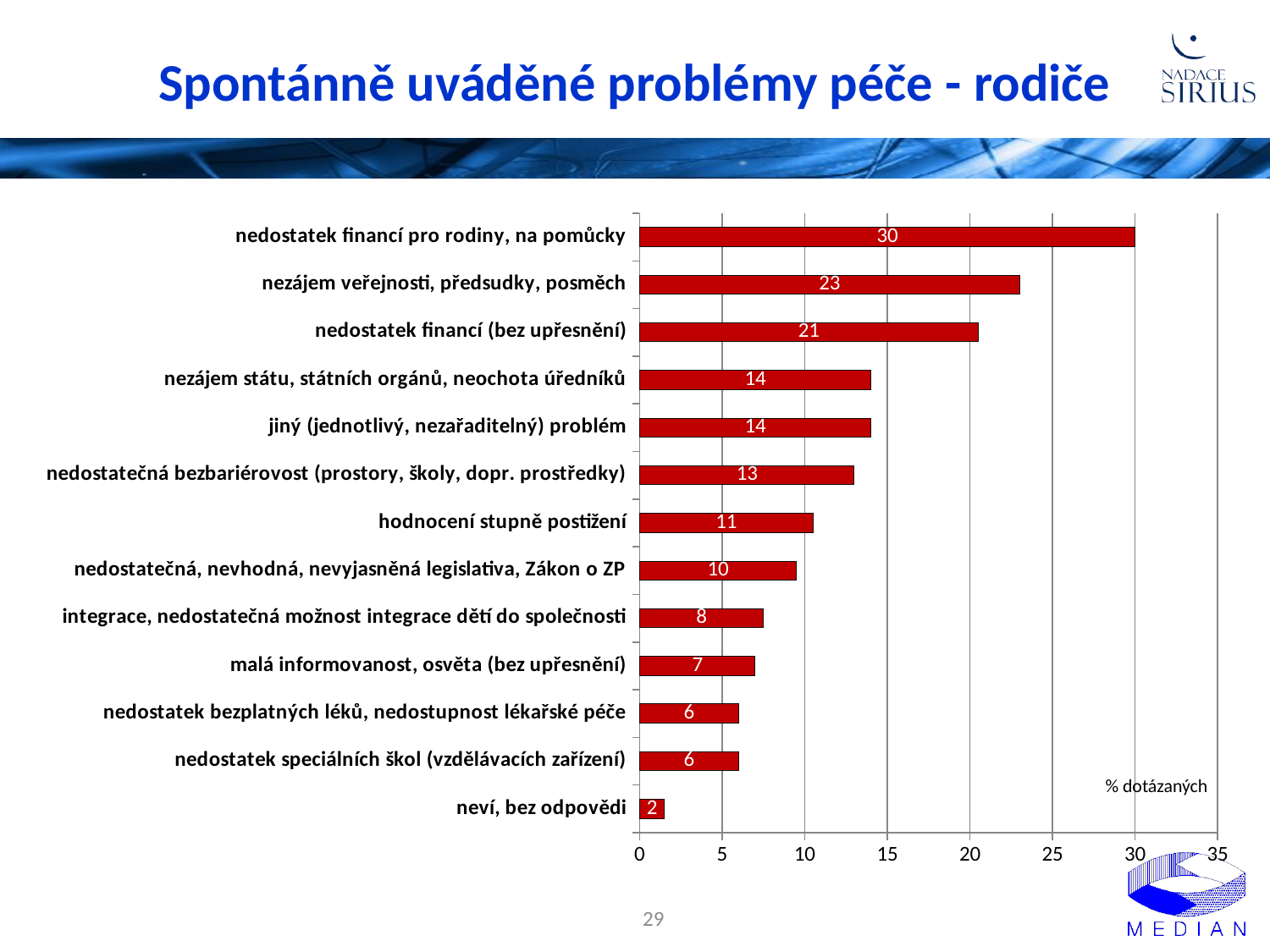
What is the value for "neví, bez odpovědi"? 2 Which is larger: the value for "nedostatečná bezbariérovost (prostory, školy, dopr. prostředky)" or the value for "integrace, nedostatečná možnost integrace dětí do společnosti"? nedostatečná bezbariérovost (prostory, školy, dopr. prostředky) How many categories are shown in the chart? 13 What kind of chart is shown on the slide? bar chart What is the value for "nezájem veřejnosti, předsudky, posměch"? 23 Which category has the highest value? nedostatek financí pro rodiny, na pomůcky What is the value for "nedostatek financí pro rodiny, na pomůcky"? 30 What is the difference between the values for "nedostatek financí pro rodiny, na pomůcky" and "nedostatek financí (bez upřesnění)"? 9 What unit label is shown next to the chart? % dotázaných What is the value for "hodnocení stupně postižení"? 11 Which category has the lowest value? neví, bez odpovědi Is the value for "nezájem veřejnosti, předsudky, posměch" greater or less than 20? greater